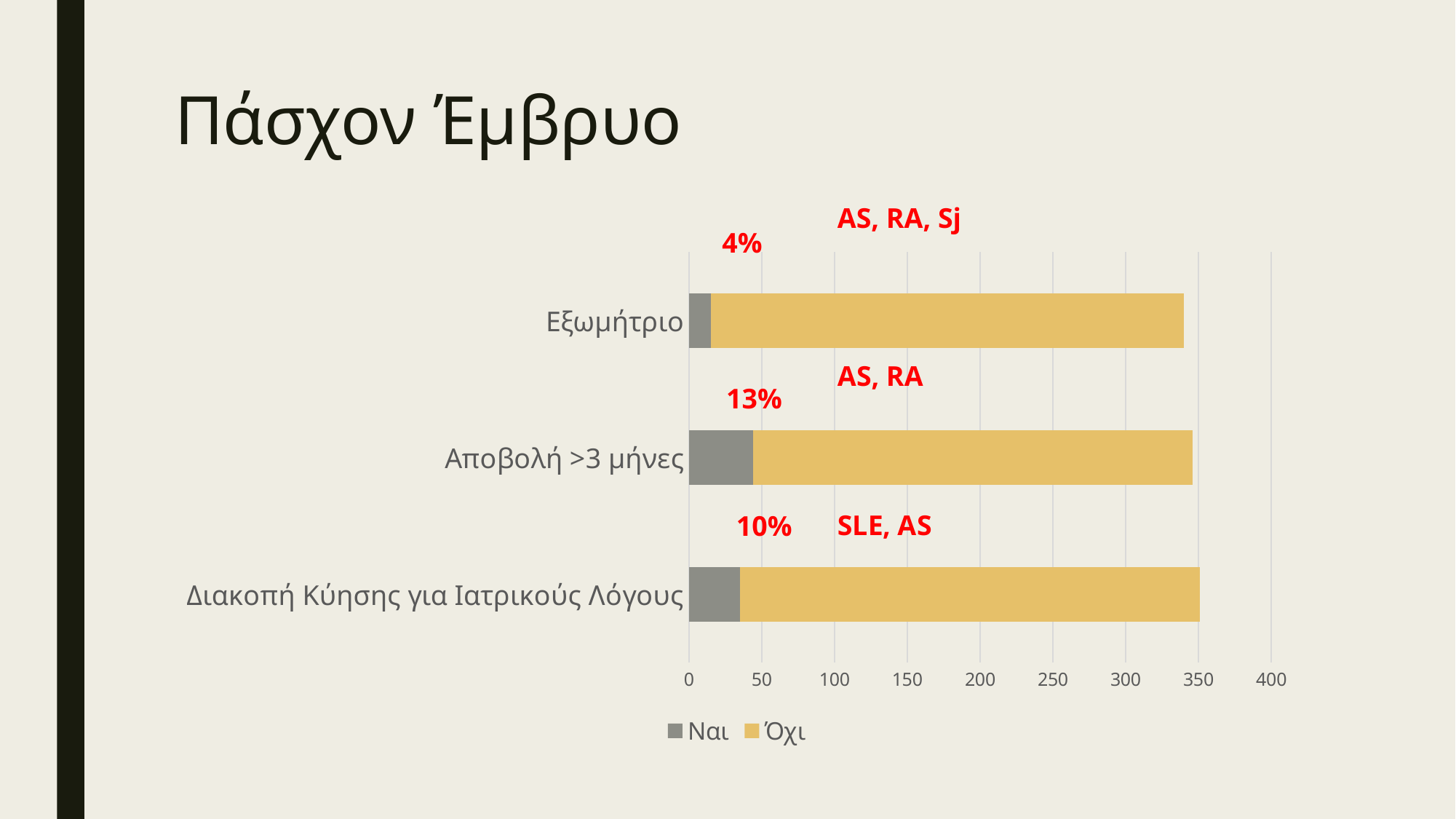
Is the Ναι value for Διακοπή Κύησης για Ιατρικούς Λόγους greater or less than 50? less How many categories are plotted on the chart? 3 Is the Ναι value for Εξωμήτριο greater or less than 50? less What is the title of the slide containing the chart? Πάσχον Έμβρυο Which is larger, the Ναι segment for Αποβολή >3 μήνες or the Ναι segment for Εξωμήτριο? Αποβολή >3 μήνες What kind of chart is shown on the slide? bar chart Which category has the smallest Ναι segment? Εξωμήτριο What are the two series named in the legend? Ναι, Όχι What percentage is annotated in red above the Αποβολή >3 μήνες bar? 13% How many series does the legend list? 2 Is the total length of the Εξωμήτριο bar greater or less than 300? greater Which category has the largest Ναι segment? Αποβολή >3 μήνες